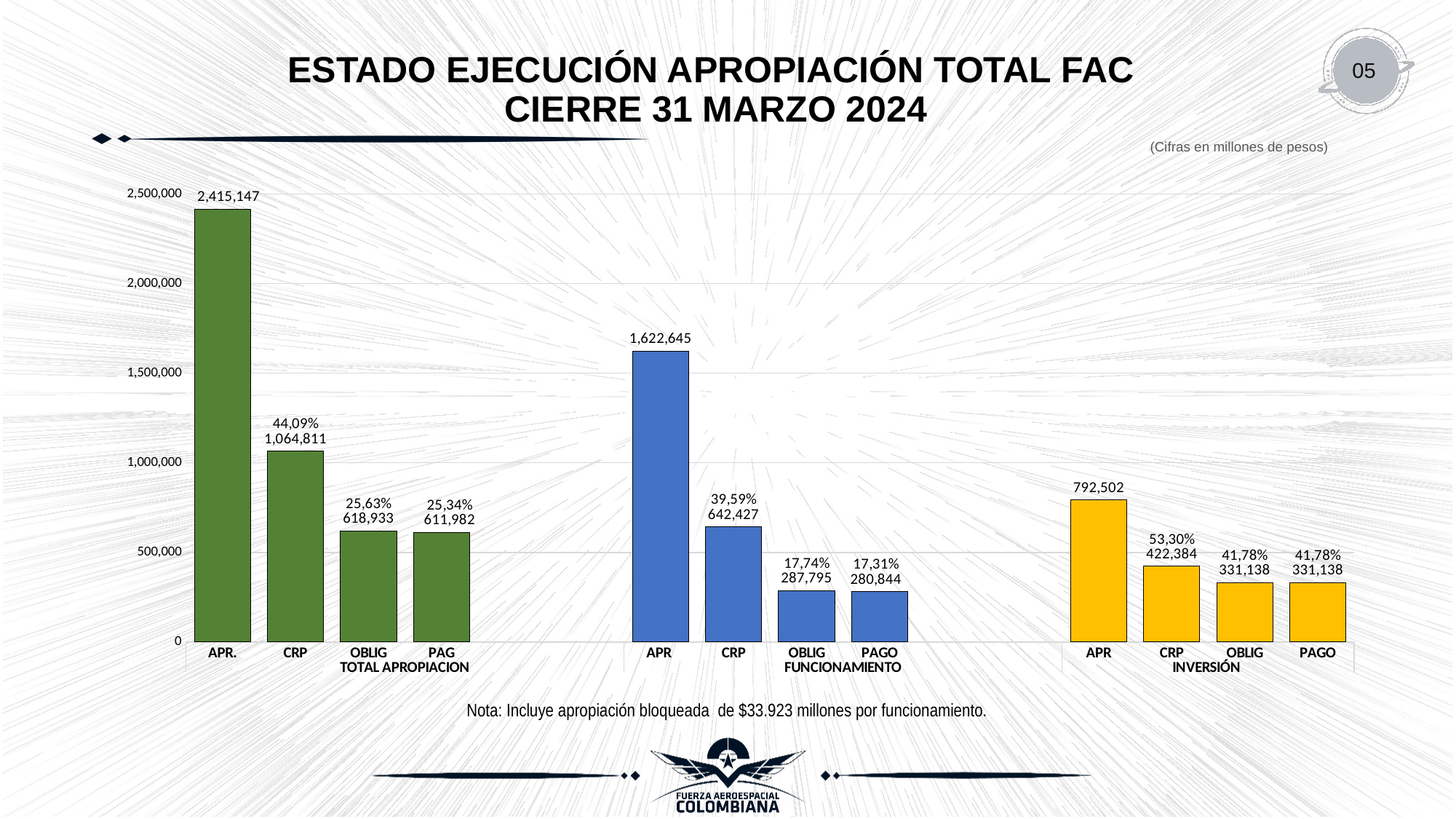
How many bars are plotted on the chart in total? 12 What percentage is shown above the CRP bar in the INVERSIÓN group? 53,30% What kind of chart is shown on the slide? bar chart Which bar has the lowest value on the chart? PAGO (FUNCIONAMIENTO) What is the value of the APR. bar in the TOTAL APROPIACION group? 2,415,147 What is the difference between the OBLIG and PAG values in the TOTAL APROPIACION group? 6,951 Is the value for APR in the FUNCIONAMIENTO group greater or less than 1,500,000? greater Which is larger: CRP in TOTAL APROPIACION or APR in INVERSIÓN? CRP in TOTAL APROPIACION What is the value of the PAGO bar in the INVERSIÓN group? 331,138 Which bar has the highest value on the chart? APR. (TOTAL APROPIACION) What is the value of the CRP bar in the FUNCIONAMIENTO group? 642,427 What is the difference between the APR and CRP values in the FUNCIONAMIENTO group? 980,218